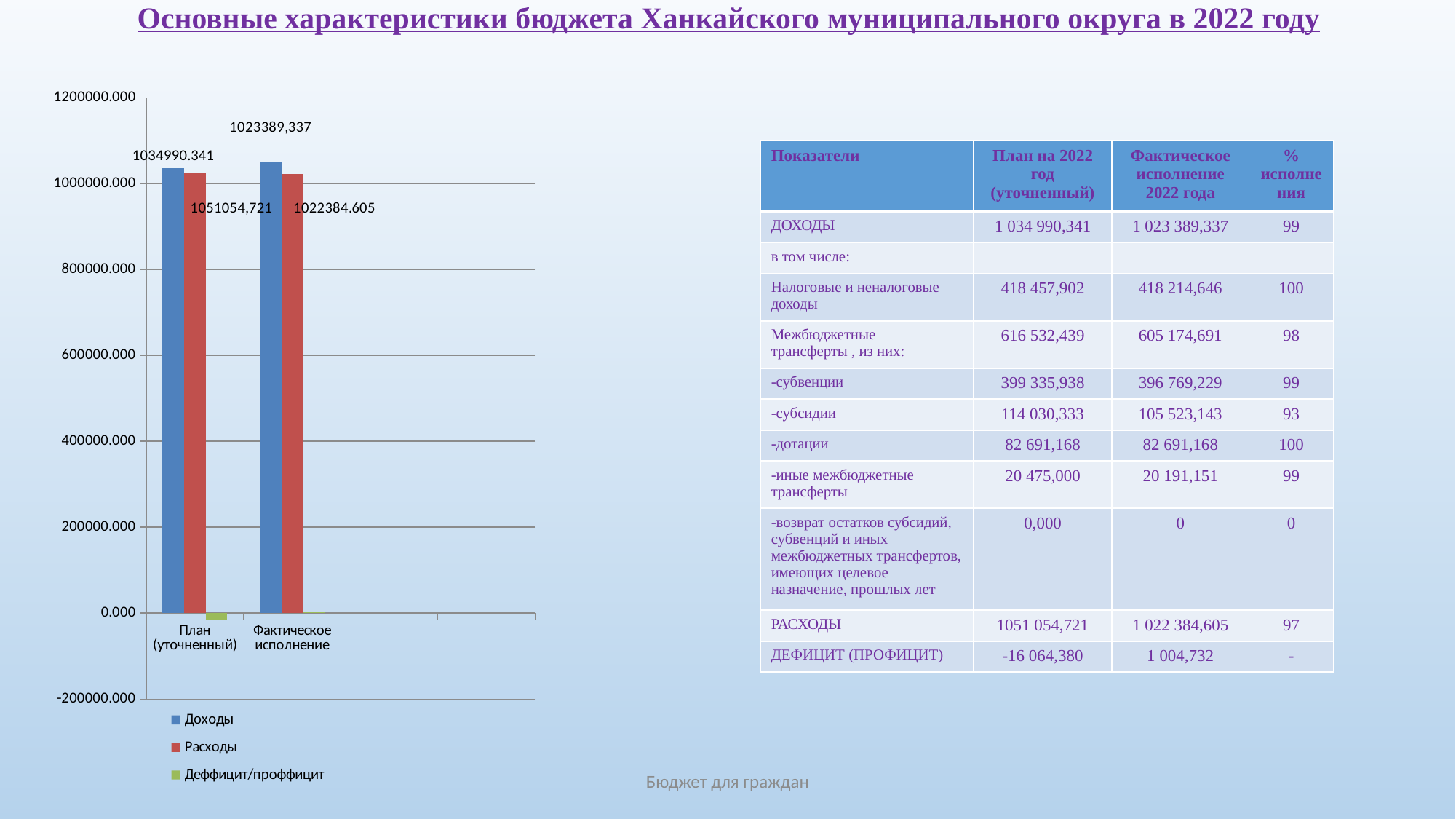
What is the value of Доходы for Фактическое исполнение in the chart? 1023389,337 What is the value of Расходы for План (уточненный) in the chart? 1051054,721 Which series in the chart is shown in green? Деффицит/проффицит Which series has the lowest value for План (уточненный) in the chart? Деффицит/проффицит What kind of chart is shown on the left of the slide? bar chart Is the value of Доходы for План (уточненный) greater or less than 1000000.000? greater How many categories are shown on the x axis of the chart? 2 What is the value of Доходы for План (уточненный) in the chart? 1034990.341 What is the value of Расходы for Фактическое исполнение in the chart? 1022384.605 Is the value of Деффицит/проффицит for План (уточненный) greater or less than 200000.000? less What are the two categories on the x axis of the chart? План (уточненный) and Фактическое исполнение How many series does the chart legend list? 3